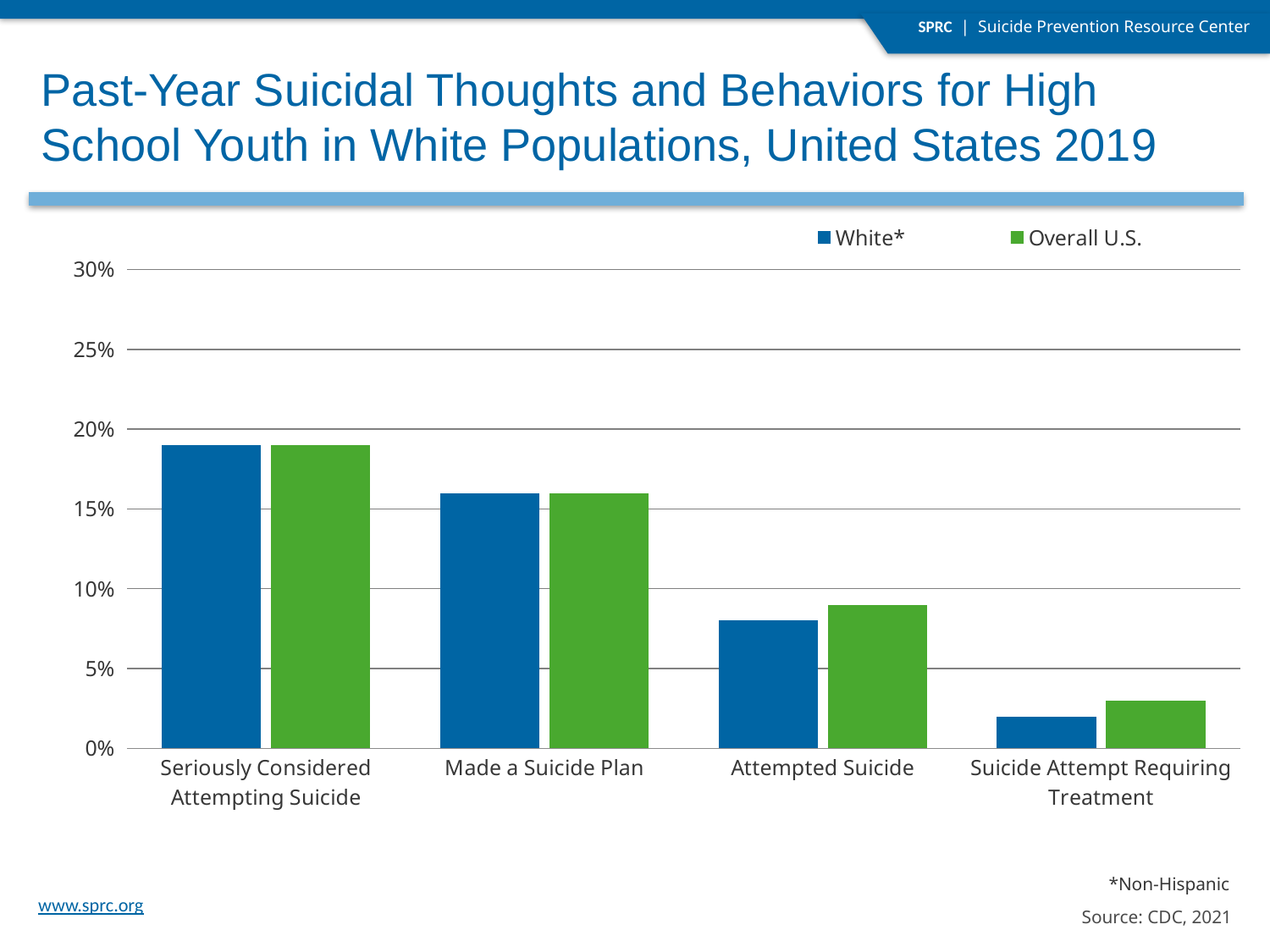
How many series does the legend list? 2 What kind of chart is shown on the slide? bar chart How many categories are shown on the x axis? 4 Is the White* value for Attempted Suicide greater or less than 10%? less Which category has the lowest value for the Overall U.S. series? Suicide Attempt Requiring Treatment Is the White* value for Seriously Considered Attempting Suicide greater or less than 15%? greater Which category has the highest value for the White* series? Seriously Considered Attempting Suicide Do the values for the White* series rise or fall moving from left to right across the categories? fall What colour are the bars for the Overall U.S. series? green Is the Overall U.S. value for Suicide Attempt Requiring Treatment greater or less than 5%? less For Suicide Attempt Requiring Treatment, which series has the larger value, White* or Overall U.S.? Overall U.S.